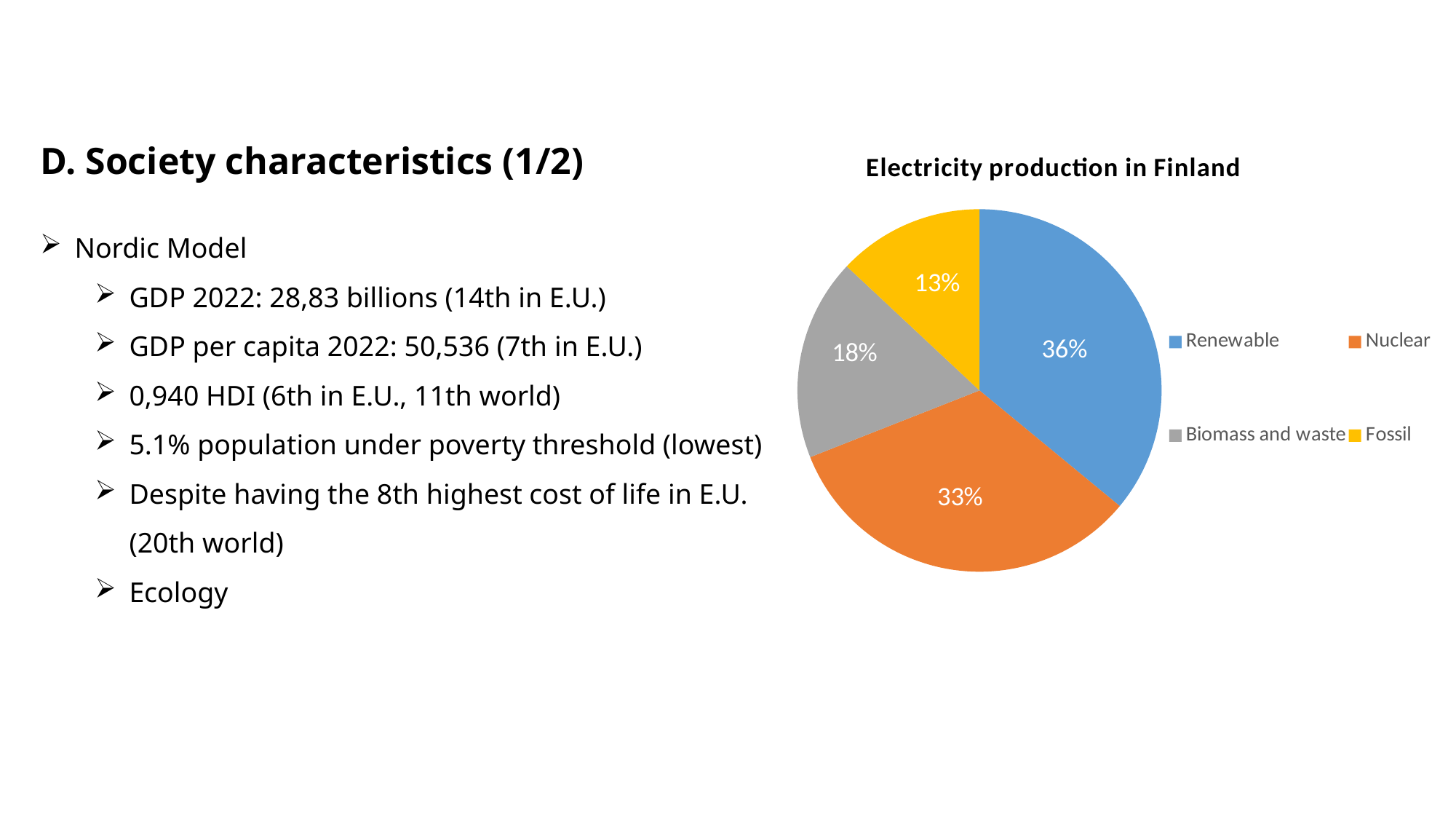
Which source has the largest share of electricity production in Finland? Renewable How many categories does the pie chart show? 4 What is the title of the chart on the slide? Electricity production in Finland What is the difference in percentage points between the Biomass and waste share and the Fossil share? 5 Which source has the smallest share of electricity production in Finland? Fossil What share of electricity production in Finland comes from Biomass and waste? 18% What is the difference in percentage points between the Renewable and Nuclear shares? 3 What share of electricity production in Finland comes from Renewable sources? 36% What share of electricity production in Finland comes from Fossil sources? 13% What type of chart is used to show electricity production in Finland? Pie chart Which has a larger share of electricity production, Biomass and waste or Fossil? Biomass and waste What share of electricity production in Finland comes from Nuclear? 33%